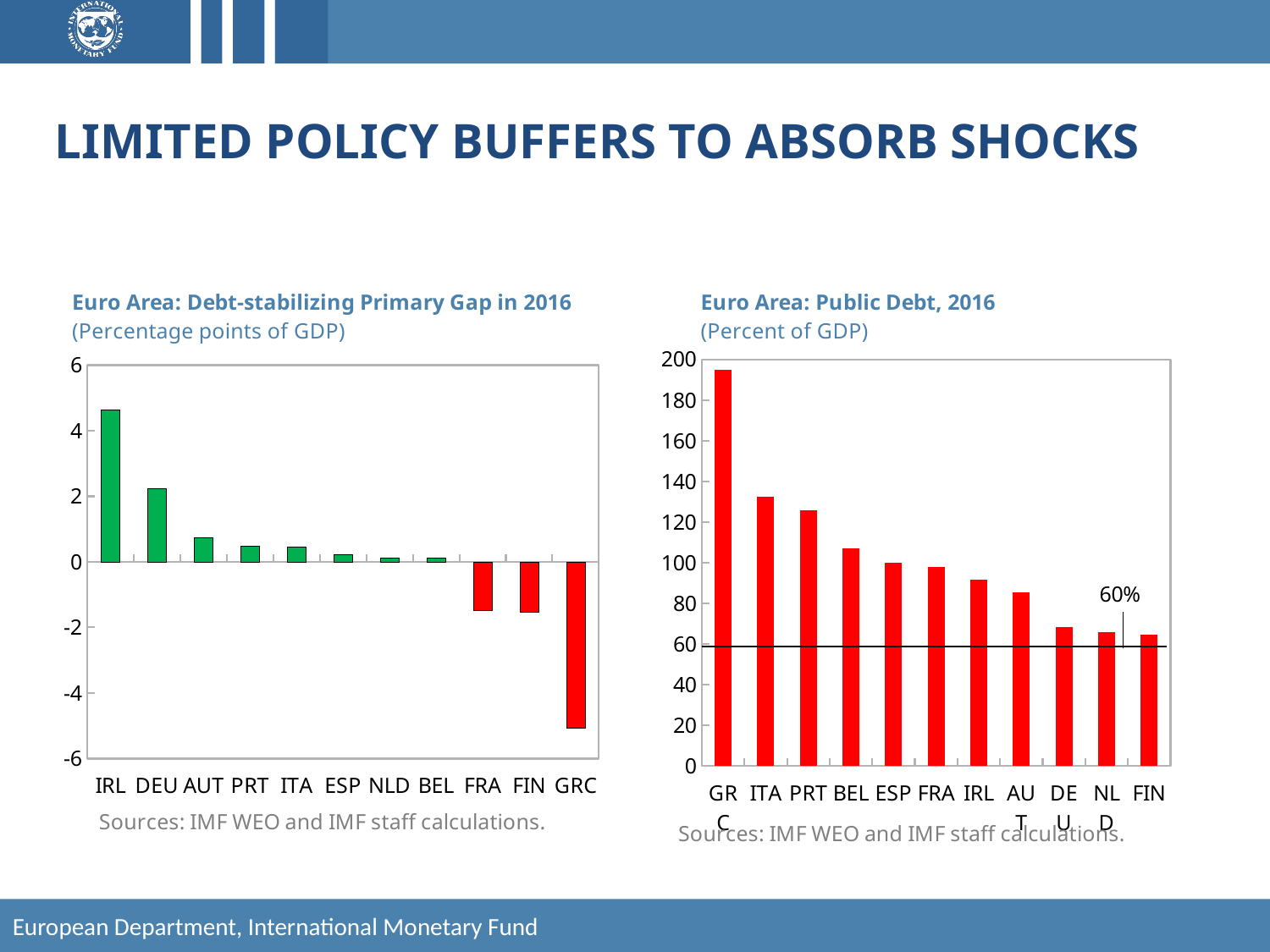
On the 'Euro Area: Debt-stabilizing Primary Gap in 2016' chart, which country has the highest value? IRL On the 'Euro Area: Public Debt, 2016' chart, which is larger, the value for PRT or the value for BEL? PRT On the 'Euro Area: Public Debt, 2016' chart, is the value for ITA greater or less than 120? greater What percentage is marked by the horizontal reference line on the 'Euro Area: Public Debt, 2016' chart? 60% On the 'Euro Area: Public Debt, 2016' chart, which country has the highest public debt? GRC On the 'Euro Area: Public Debt, 2016' chart, do the values rise or fall from left to right? fall On the 'Euro Area: Debt-stabilizing Primary Gap in 2016' chart, which country has the lowest value? GRC How many countries are shown on the 'Euro Area: Public Debt, 2016' chart? 11 On the 'Euro Area: Debt-stabilizing Primary Gap in 2016' chart, is the value for DEU greater or less than 4? less On the 'Euro Area: Public Debt, 2016' chart, is the value for DEU greater or less than 80? less On the 'Euro Area: Public Debt, 2016' chart, which country has the lowest public debt? FIN What kind of chart is the 'Euro Area: Debt-stabilizing Primary Gap in 2016' chart? bar chart